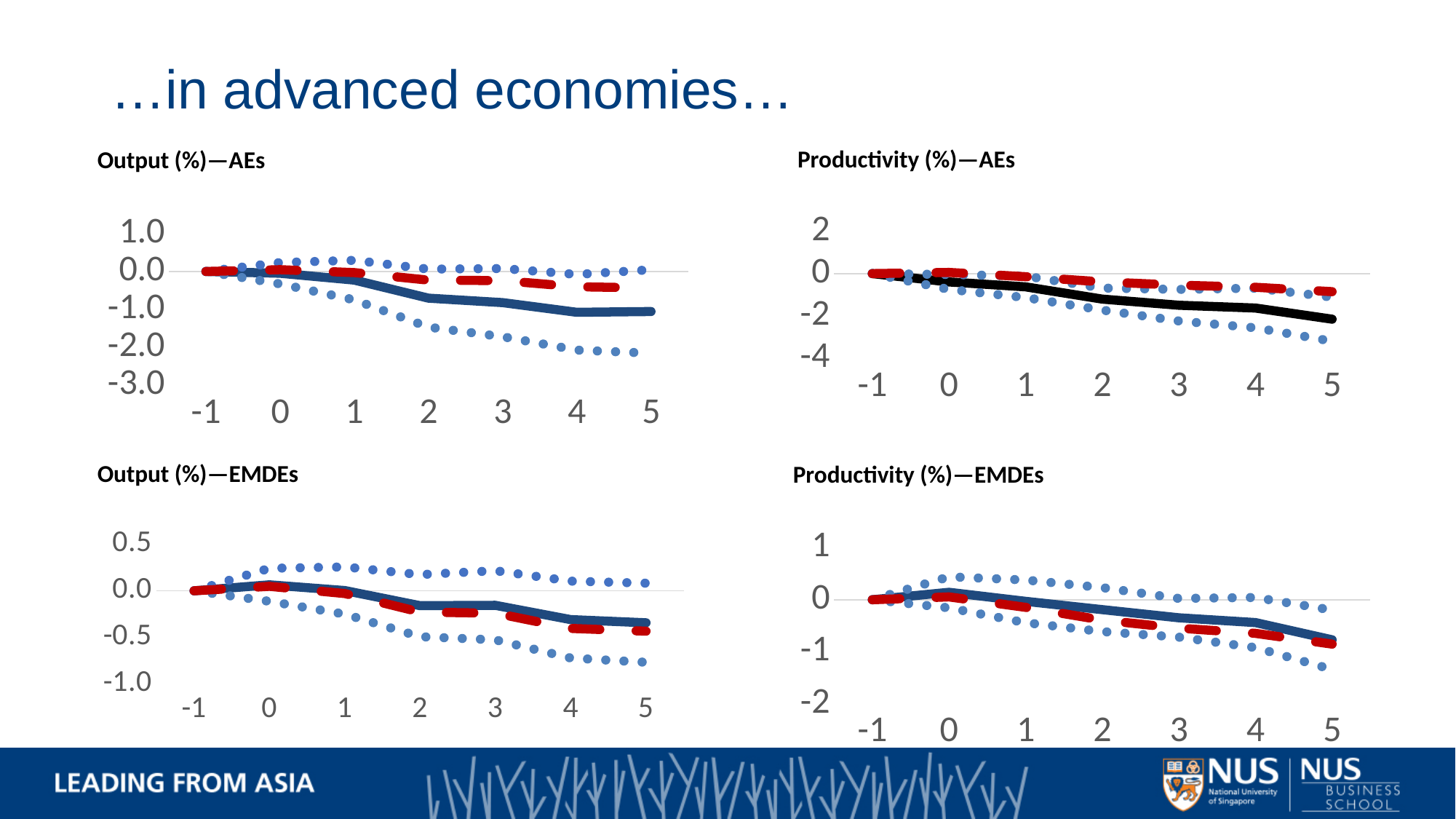
In the "Productivity (%)—AEs" chart, does the solid line rise or fall along the x axis? fall In the "Productivity (%)—AEs" chart, is the solid line's value at x = 5 greater or less than -4? greater How many charts are shown on the slide? 4 In the "Output (%)—AEs" chart, does the solid line rise or fall from x = -1 to x = 5? fall In the "Output (%)—AEs" chart, how many points are labelled on the x axis? 7 What kind of chart is "Output (%)—AEs"? line chart In the "Productivity (%)—EMDEs" chart, is the solid line's value at x = 5 greater or less than 0? less In the "Productivity (%)—AEs" chart, is the solid line's value at x = 5 greater or less than 0? less In the "Output (%)—EMDEs" chart, what is the lowest value labelled on the y axis? -1.0 In the "Productivity (%)—EMDEs" chart, does the solid line rise or fall from x = 0 to x = 5? fall